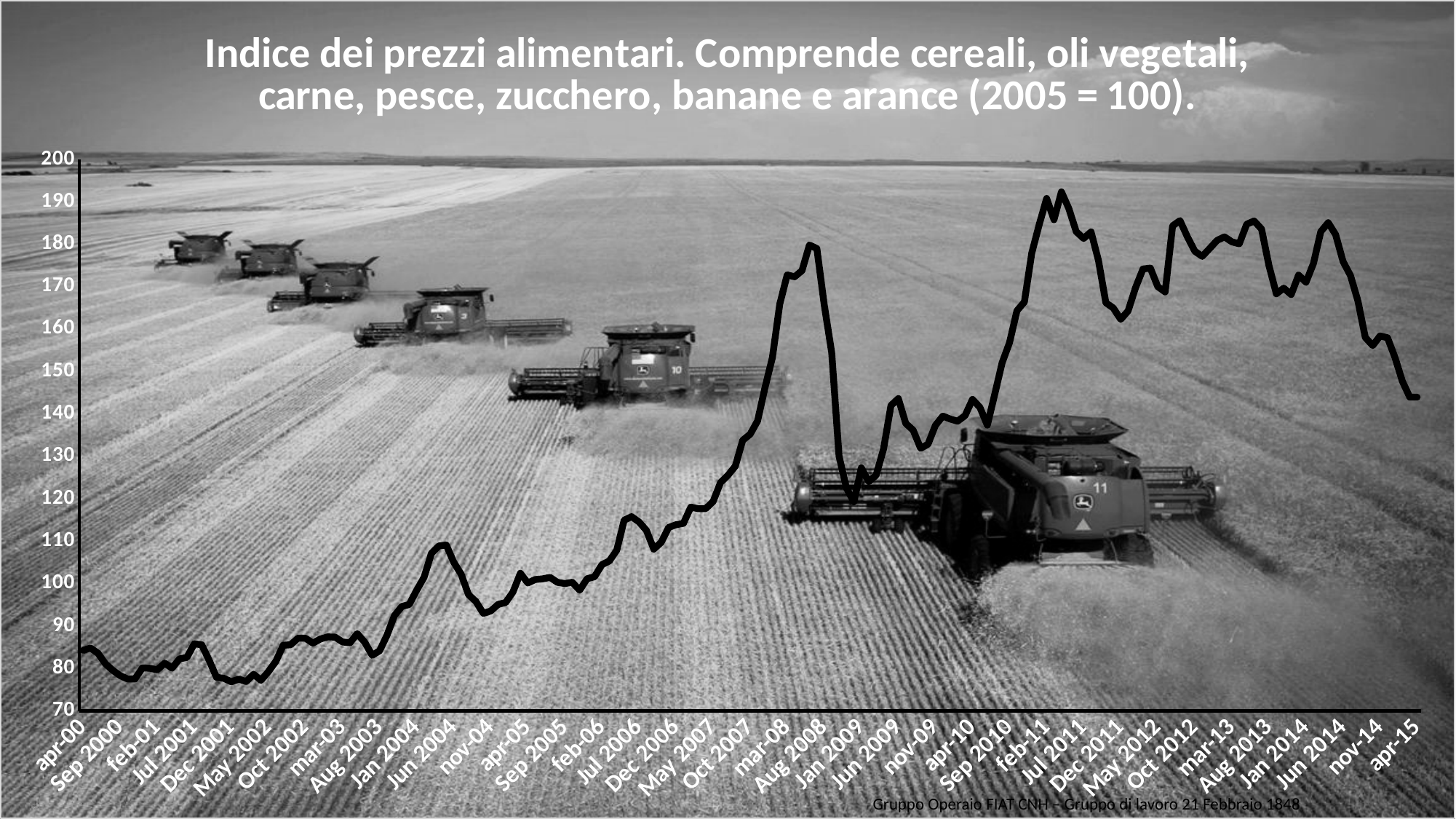
Does the index overall rise or fall between apr-00 and feb-11? rise What kind of chart is shown on the slide? line chart Is the value of the index at Jul 2001 greater or less than 90? less Is the value of the index at apr-00 greater or less than 90? less Around which x-axis label does the index reach its highest point? feb-11 Is the value of the index at feb-11 greater or less than 180? greater What is the highest value shown on the vertical axis? 200 What is the base year of the food price index according to the chart title? 2005 = 100 Does the index rise or fall between Jun 2014 and apr-15? fall